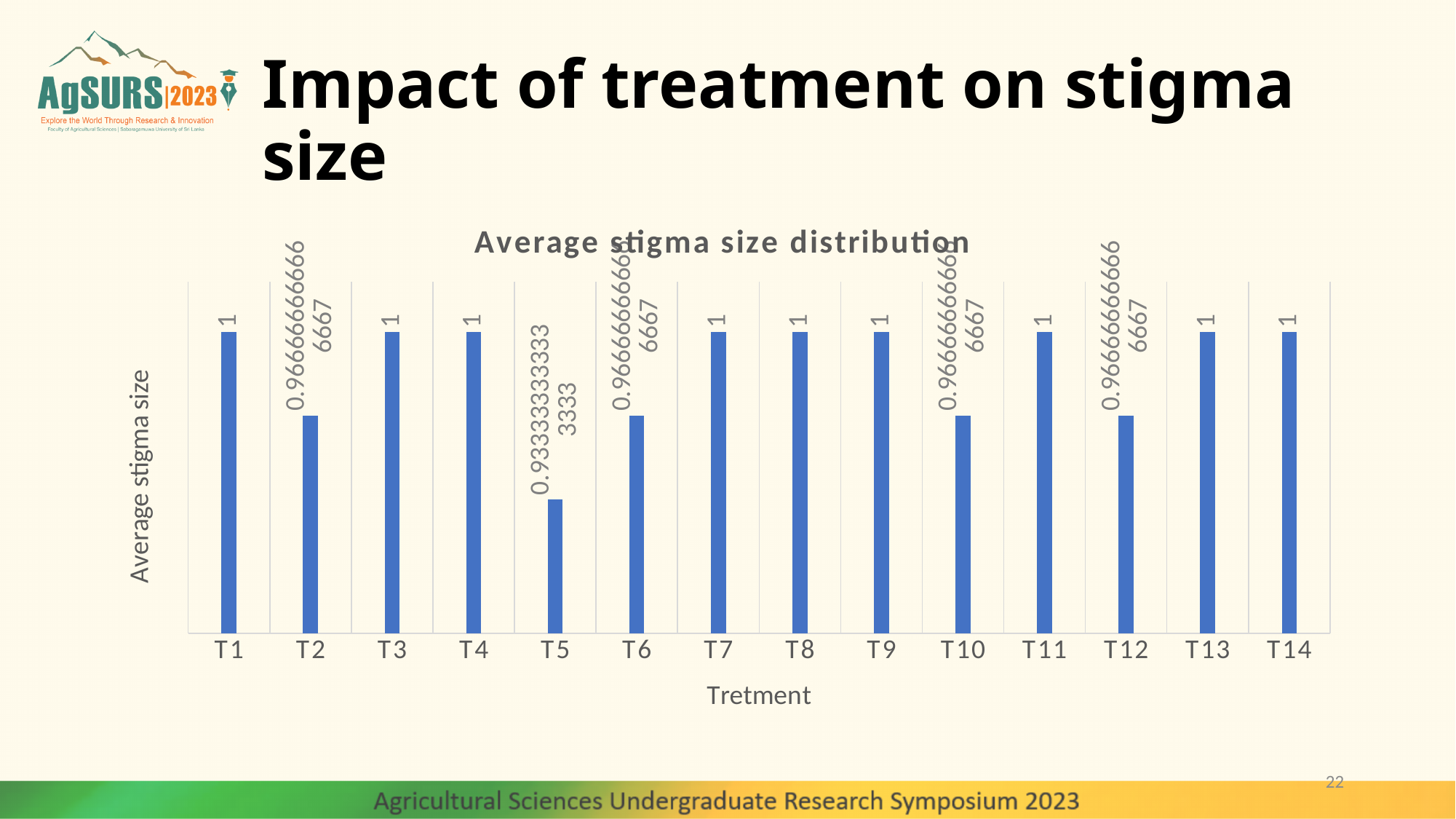
How many treatments are plotted on the x axis of the chart? 14 Which treatment has the lowest average stigma size? T5 What is the average stigma size for T14? 1 What is the title of the chart? Average stigma size distribution Which has the larger average stigma size, T5 or T6? T6 Which has the larger average stigma size, T2 or T4? T4 How many treatments have an average stigma size of exactly 1? 9 What is the average stigma size for T1? 1 What is the average stigma size for T7? 1 Which has the larger average stigma size, T3 or T5? T3 What kind of chart is shown on the slide? bar chart What is the label on the x axis of the chart? Tretment